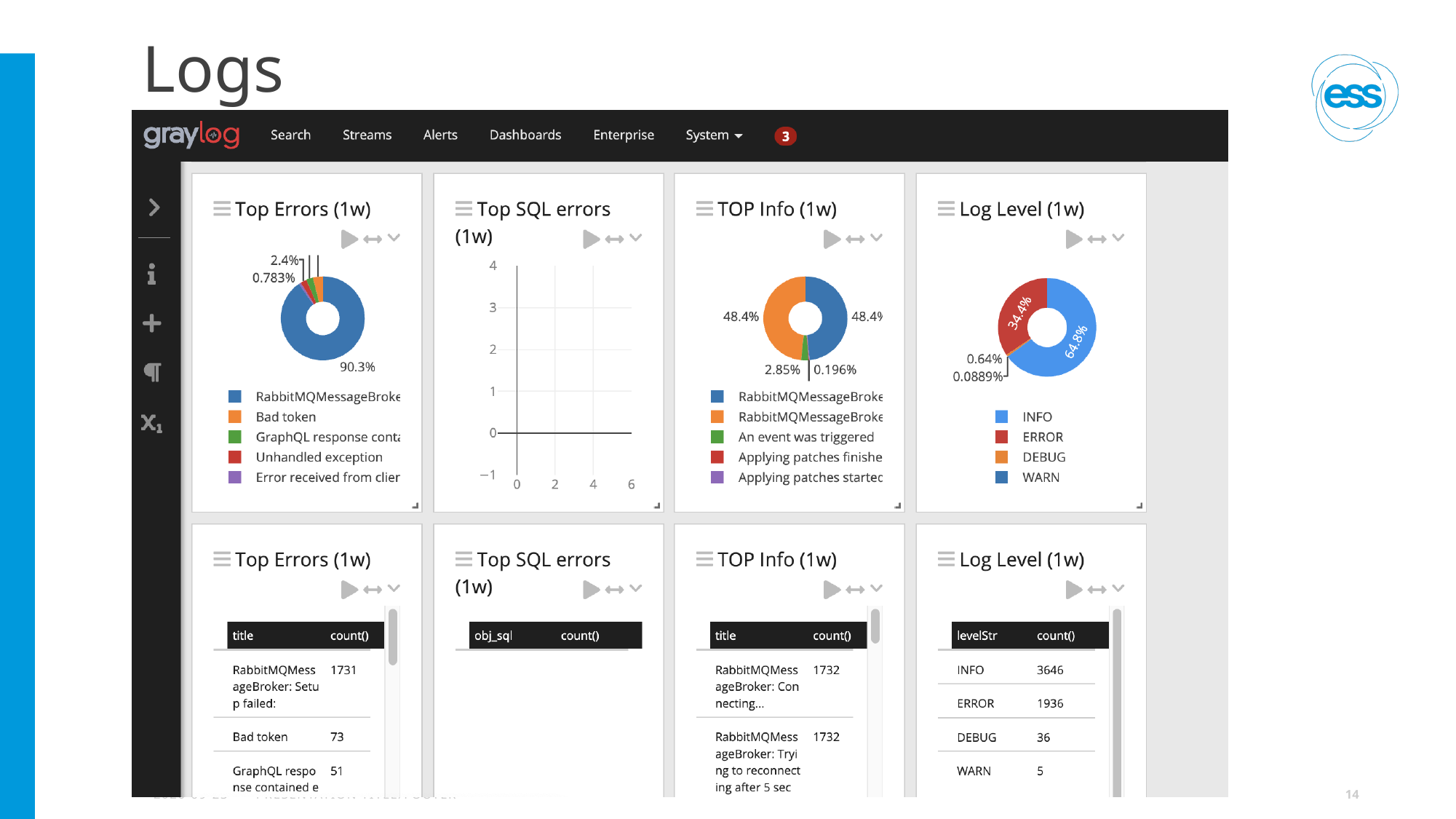
In the Log Level (1w) table at the bottom right, what is the count() for WARN? 5 How many entries does the legend of the Top Errors (1w) donut chart list? 5 In the Log Level (1w) table, which level has the lowest count()? WARN In the Log Level (1w) table at the bottom right, what is the count() for INFO? 3646 In the Log Level (1w) donut chart, what share is labelled for the ERROR slice? 34.4% In the Top Errors (1w) donut chart, what share is labelled on the largest slice? 90.3% In the Log Level (1w) table, what is the difference between the INFO count and the ERROR count? 1710 In the Log Level (1w) donut chart, which slice is larger: INFO or ERROR? INFO In the Top Errors (1w) table at the bottom left, what is the count() for Bad token? 73 What kind of chart is the Top Errors (1w) chart in the top-left panel? Donut (pie) chart In the Log Level (1w) donut chart, what share is labelled for the INFO slice? 64.8% How many entries does the legend of the Log Level (1w) donut chart list? 4